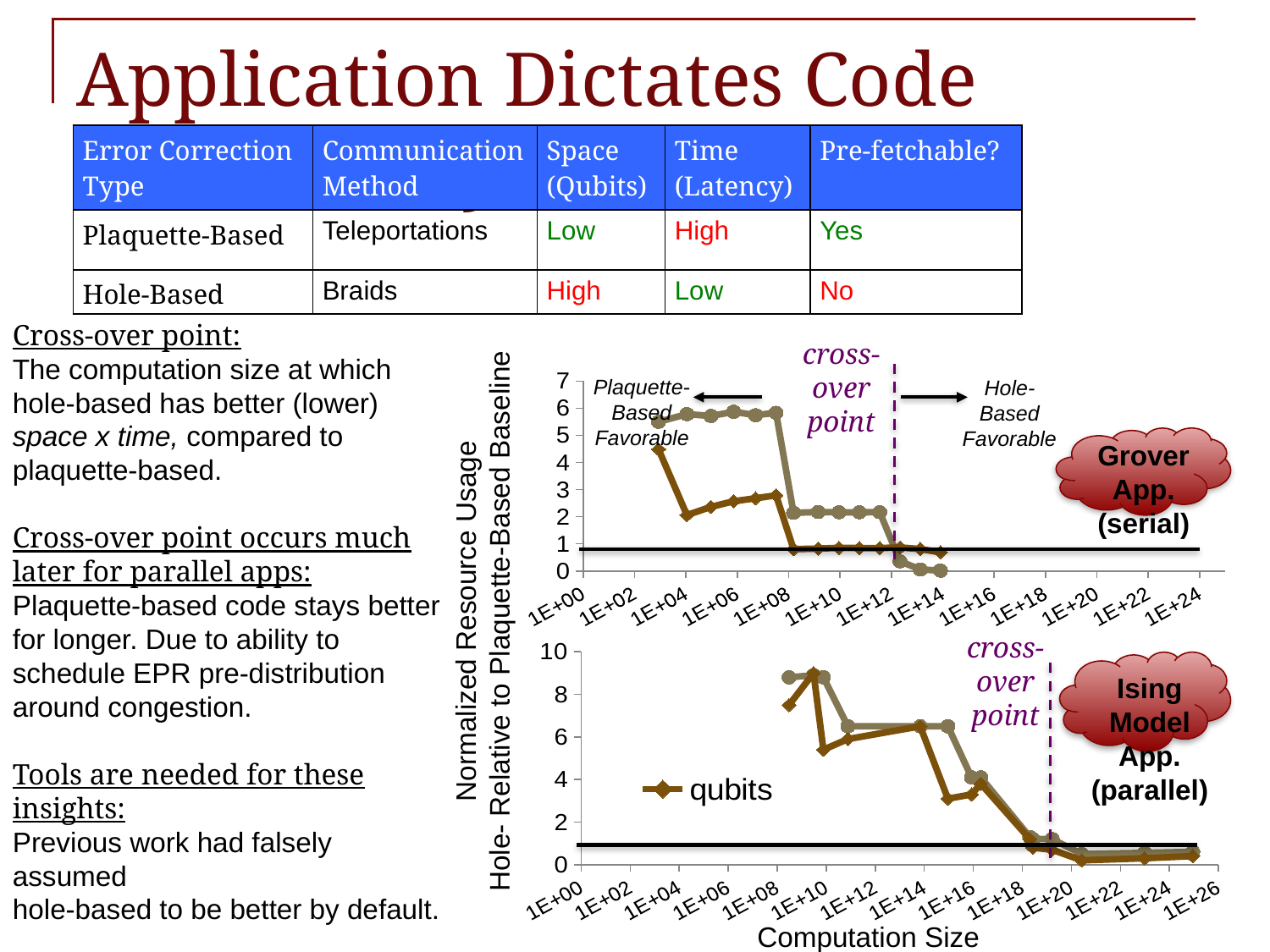
In the top chart (Grover App), is the value of the lower (brown) line at 1E+10 greater or less than 2? less What is the x-axis title shared by the charts? Computation Size In the bottom chart (Ising Model App), how many series does the legend list? 1 What kind of chart is the bottom chart (Ising Model App, parallel)? line chart In the top chart (Grover App), do the plotted values generally rise or fall as computation size increases? fall In the bottom chart (Ising Model App), do the plotted values generally rise or fall as computation size increases? fall In the bottom chart (Ising Model App), is the value of the upper (grey) line at 1E+10 greater or less than 8? greater In the top chart (Grover App), is the value of the upper (grey) line at 1E+04 greater or less than 5? greater What kind of chart is the top chart (Grover App, serial)? line chart In the bottom chart (Ising Model App), what is the series name shown in the legend? qubits